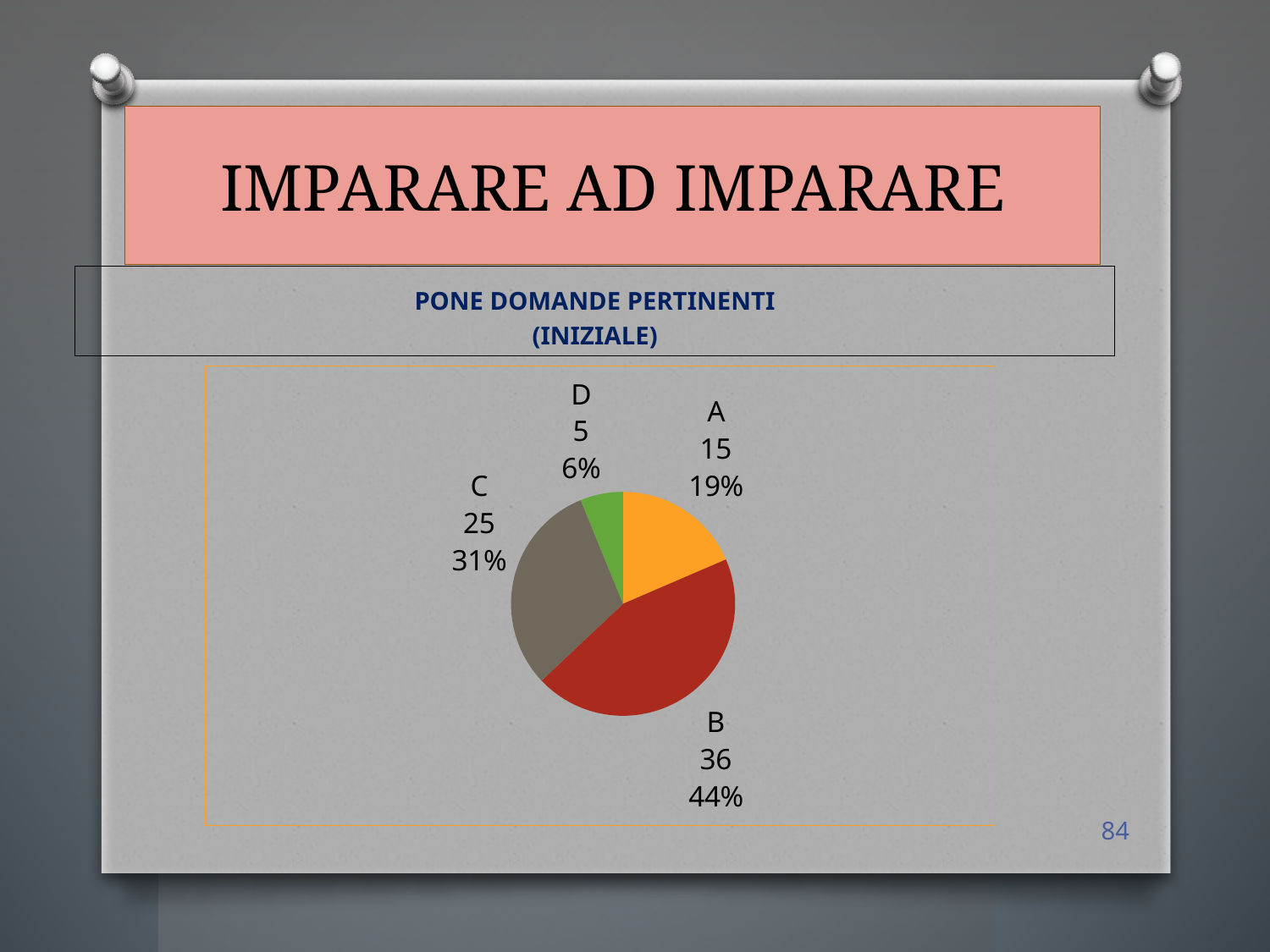
What share of the pie does category A represent? 19% What share of the pie does category C represent? 31% Which category has the smallest slice of the pie? D Which category has the largest slice of the pie? B What is the value for category B? 36 How many categories are shown in the pie chart? 4 What kind of chart is shown on the slide? pie chart What is the value for category D? 5 Which is larger, the value for A or the value for D? A What is the value for category A? 15 What is the value for category C? 25 What is the difference between the values for B and C? 11